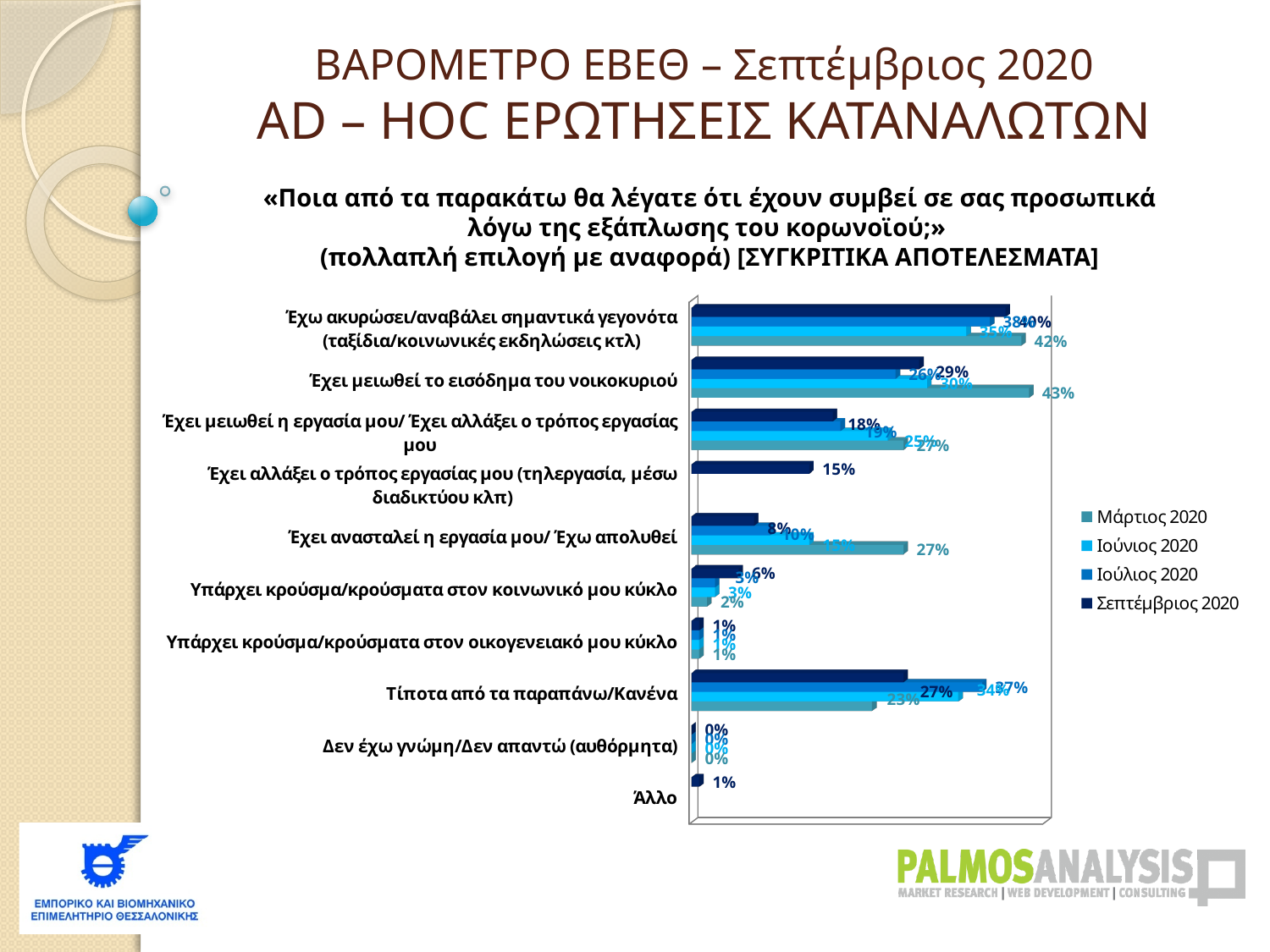
What is the Μάρτιος 2020 value for 'Έχει μειωθεί το εισόδημα του νοικοκυριού'? 43% For Μάρτιος 2020, which is larger: 'Έχει ανασταλεί η εργασία μου/ Έχω απολυθεί' or 'Τίποτα από τα παραπάνω/Κανένα'? Έχει ανασταλεί η εργασία μου/ Έχω απολυθεί How many series does the legend list? 4 What is the Μάρτιος 2020 value for 'Έχει ανασταλεί η εργασία μου/ Έχω απολυθεί'? 27% What is the Σεπτέμβριος 2020 value for 'Έχει ανασταλεί η εργασία μου/ Έχω απολυθεί'? 8% What is the Μάρτιος 2020 value for 'Έχω ακυρώσει/αναβάλει σημαντικά γεγονότα (ταξίδια/κοινωνικές εκδηλώσεις κτλ)'? 42% What kind of chart is shown on the slide? Bar chart What is the difference between the Μάρτιος 2020 values for 'Έχει μειωθεί το εισόδημα του νοικοκυριού' and 'Έχω ακυρώσει/αναβάλει σημαντικά γεγονότα'? 1% Which series is shown in the darkest navy colour in the legend? Σεπτέμβριος 2020 What is the Σεπτέμβριος 2020 value for 'Άλλο'? 1% What is the Σεπτέμβριος 2020 value for 'Έχει αλλάξει ο τρόπος εργασίας μου (τηλεργασία, μέσω διαδικτύου κλπ)'? 15% How many categories are shown on the chart? 10